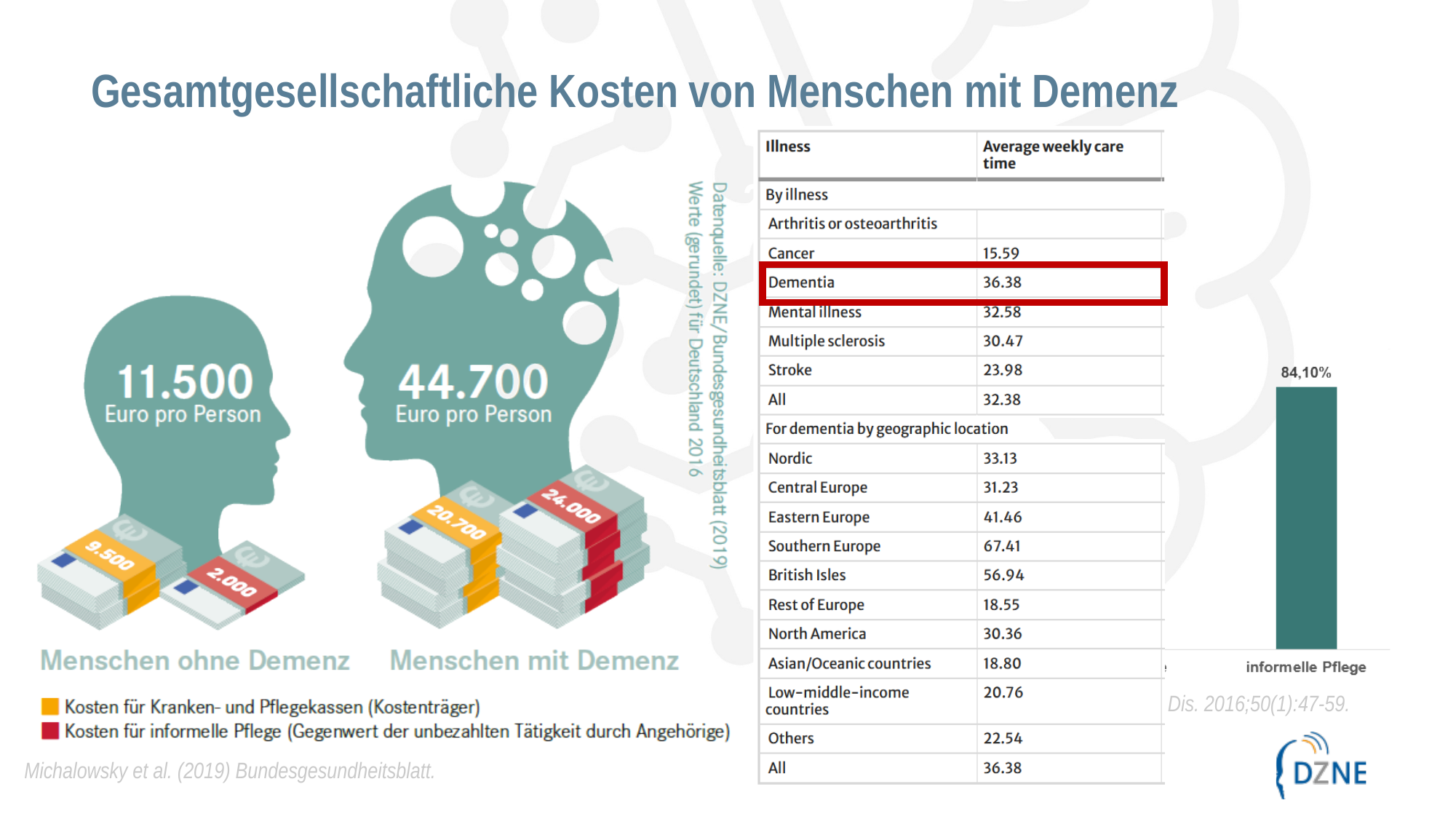
In the infographic on the left, which group has the higher total cost per person, 'Menschen ohne Demenz' or 'Menschen mit Demenz'? Menschen mit Demenz In the bar chart on the right, what is the value shown for 'informelle Pflege'? 84,10% In the infographic on the left, what are the 'Kosten für Kranken- und Pflegekassen' for 'Menschen mit Demenz'? 20.700 In the infographic on the left, how many cost categories does the legend list? 2 In the infographic on the left, what are the 'Kosten für informelle Pflege' for 'Menschen mit Demenz'? 24.000 In the infographic on the left, what is the total cost per person for 'Menschen ohne Demenz'? 11.500 Euro pro Person In the infographic on the left, what is the total cost per person for 'Menschen mit Demenz'? 44.700 Euro pro Person In the infographic on the left, what are the 'Kosten für informelle Pflege' for 'Menschen ohne Demenz'? 2.000 In the infographic on the left, what are the 'Kosten für Kranken- und Pflegekassen' for 'Menschen ohne Demenz'? 9.500 In the infographic on the left, which colour represents 'Kosten für informelle Pflege'? Red In the infographic on the left, for 'Menschen mit Demenz', which is larger: the 'Kosten für Kranken- und Pflegekassen' or the 'Kosten für informelle Pflege'? Kosten für informelle Pflege In the infographic on the left, what is the difference in total cost per person between 'Menschen mit Demenz' and 'Menschen ohne Demenz'? 33.200 Euro